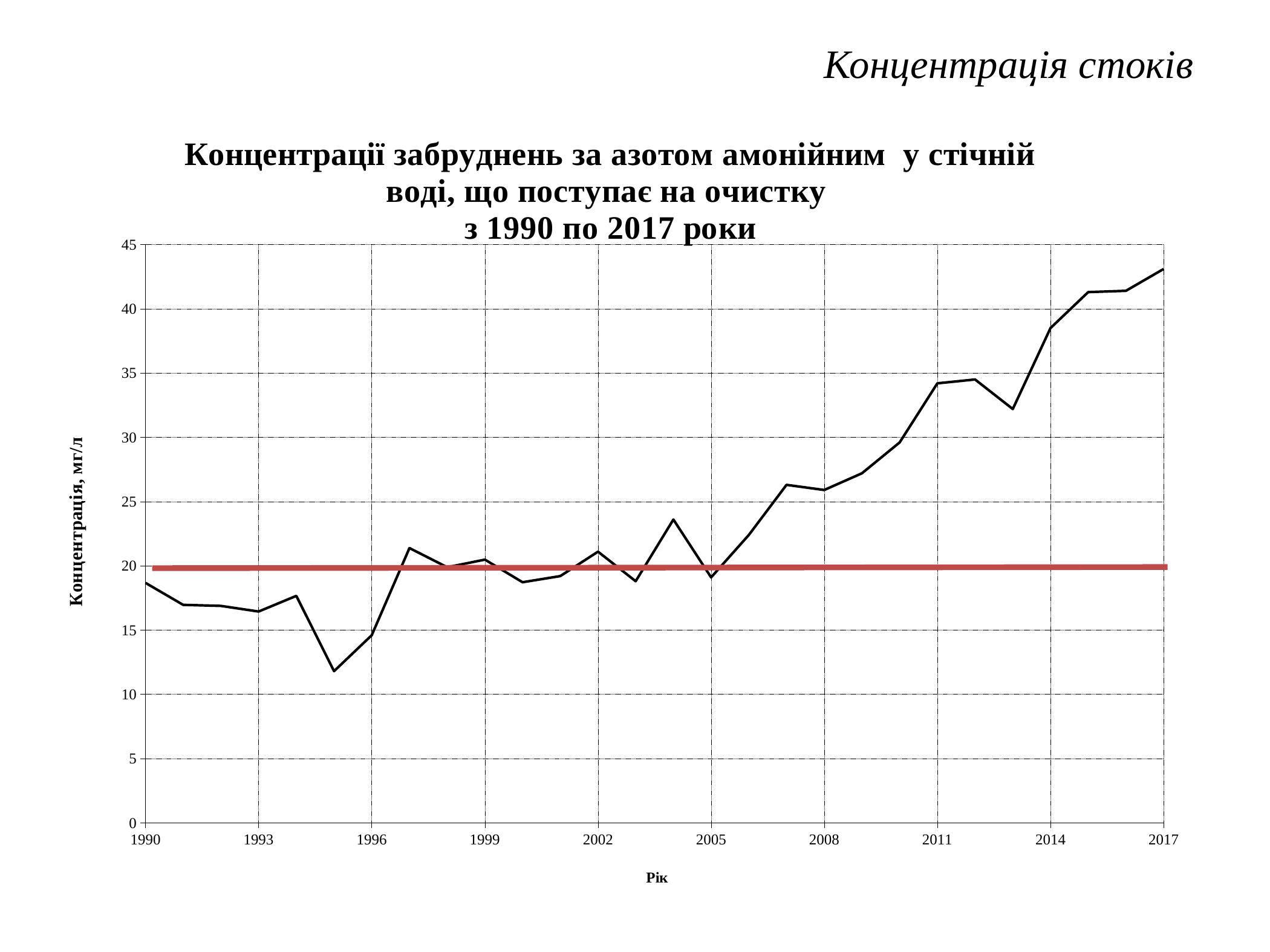
Is the value for 2017 greater or less than 40? greater Is the value for 2014 greater or less than 35? greater Overall, do the concentration values rise or fall from 1990 to 2017? rise Is the value for 2011 greater or less than 30? greater Which year has the larger concentration, 2008 or 1993? 2008 In which year is the ammonium nitrogen concentration highest? 2017 What kind of chart is shown on the slide? line chart What is the label of the vertical axis? Концентрація, мг/л What is the label of the horizontal axis? Рік In which year is the ammonium nitrogen concentration lowest? 1995